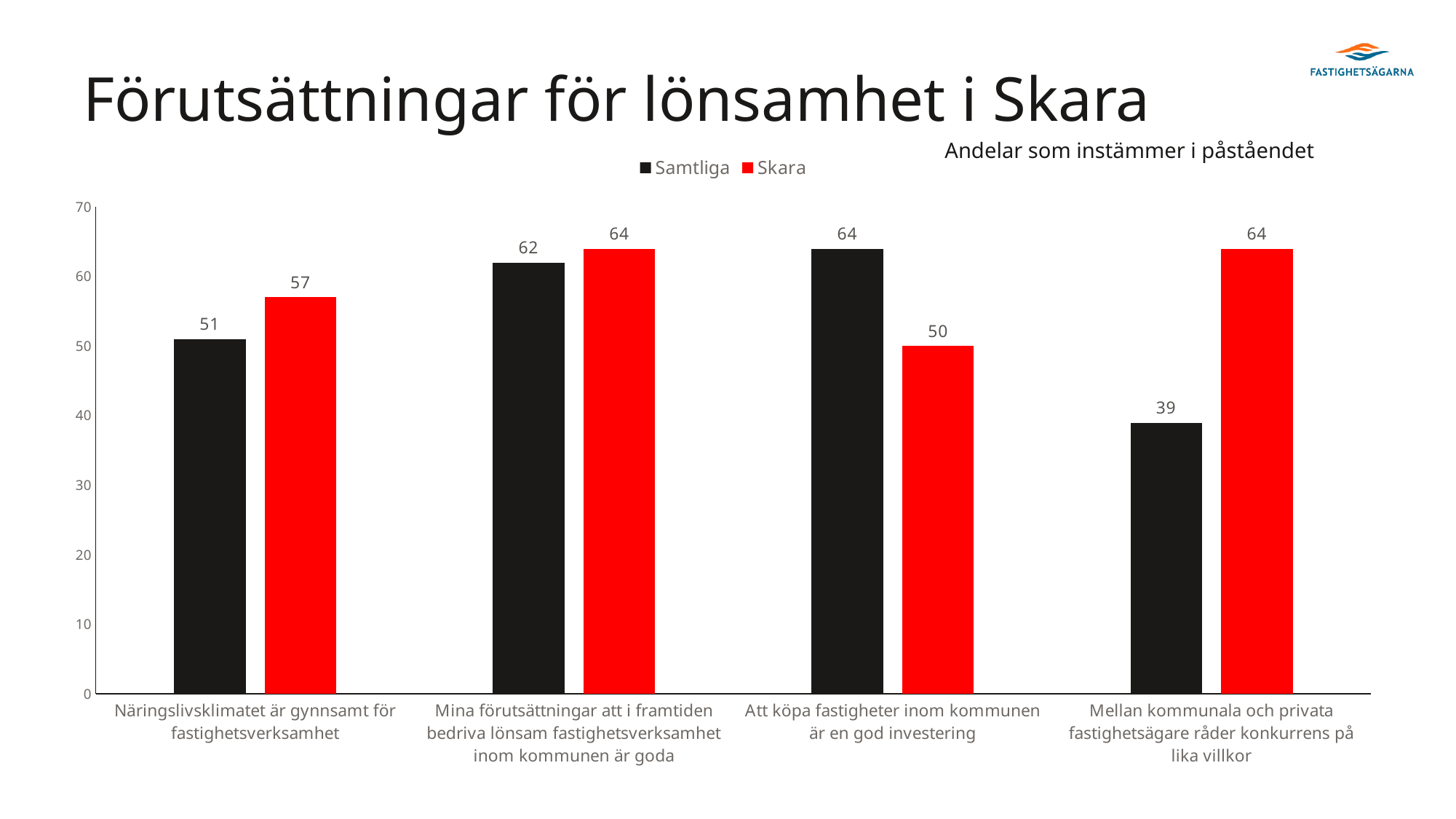
What is the difference between the Skara and Samtliga values for "Näringslivsklimatet är gynnsamt för fastighetsverksamhet"? 6 How many series does the legend list? 2 What is the Skara value for "Att köpa fastigheter inom kommunen är en god investering"? 50 Is the Samtliga value for "Mellan kommunala och privata fastighetsägare råder konkurrens på lika villkor" greater or less than 40? less For "Att köpa fastigheter inom kommunen är en god investering", which series has the larger value, Samtliga or Skara? Samtliga Which category has the lowest Samtliga value? Mellan kommunala och privata fastighetsägare råder konkurrens på lika villkor How many categories are shown on the x axis? 4 Which category has the lowest Skara value? Att köpa fastigheter inom kommunen är en god investering What kind of chart is shown on the slide? bar chart What is the difference between the Skara and Samtliga values for "Mellan kommunala och privata fastighetsägare råder konkurrens på lika villkor"? 25 What is the Samtliga value for "Mellan kommunala och privata fastighetsägare råder konkurrens på lika villkor"? 39 What is the Samtliga value for "Näringslivsklimatet är gynnsamt för fastighetsverksamhet"? 51